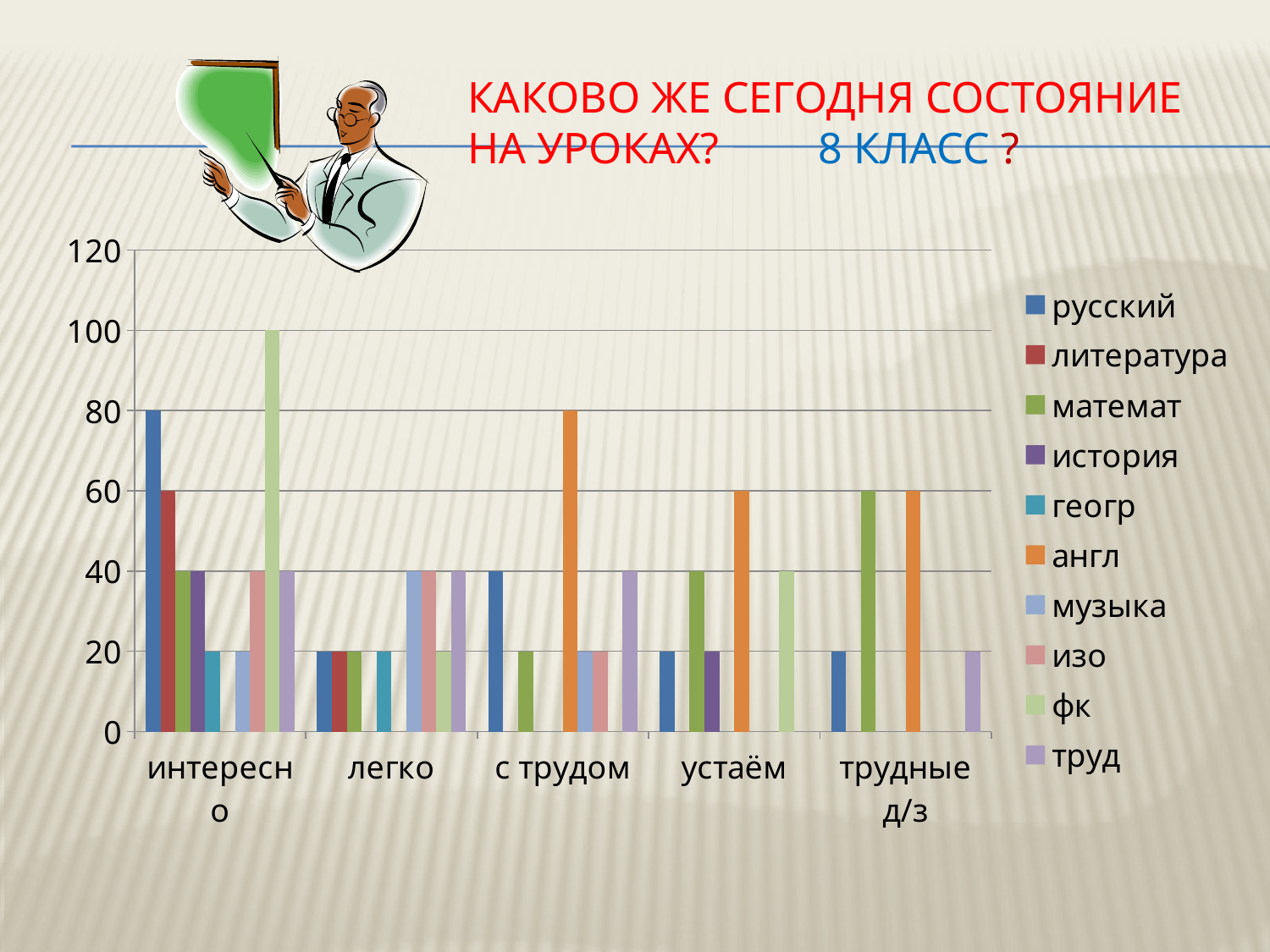
Which is larger in the легко category: музыка or русский? музыка What is the value for русский in the интересно category? 80 What is the value for математ in the трудные д/з category? 60 What kind of chart is shown on the slide? bar chart What is the difference between русский and литература in the интересно category? 20 How many series does the legend list? 10 What is the value for англ in the с трудом category? 80 How many categories are shown along the x axis? 5 Which series is listed first in the legend? русский What is the value for фк in the интересно category? 100 Which series has the highest value in the интересно category? фк Which series has the highest value in the устаём category? англ